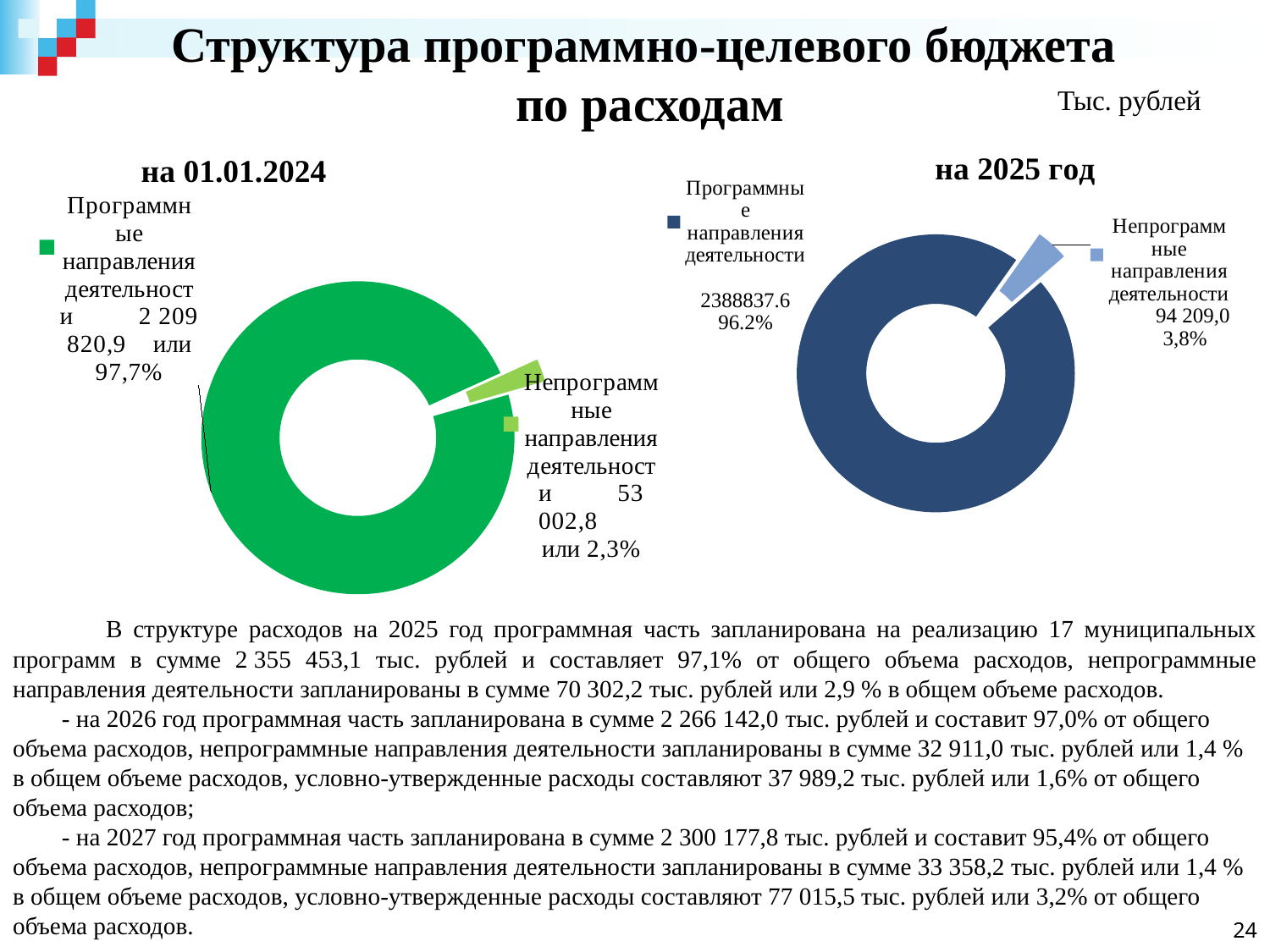
In the 'на 2025 год' chart, which category has the largest slice? Программные направления деятельности In the 'на 2025 год' chart, what value is shown for Непрограммные направления деятельности? 94 209,0 In the 'на 01.01.2024' chart, what value is shown for Программные направления деятельности? 2 209 820,9 In the 'на 01.01.2024' chart, what share is shown for Непрограммные направления деятельности? 2,3% In the 'на 2025 год' chart, what share is shown for Непрограммные направления деятельности? 3,8% In the 'на 2025 год' chart, what value is shown for Программные направления деятельности? 2388837.6 In the 'на 2025 год' chart, what share is shown for Программные направления деятельности? 96.2% In the 'на 01.01.2024' chart, which category has the smallest slice? Непрограммные направления деятельности Which is larger: the share of Непрограммные направления деятельности in the 'на 01.01.2024' chart or in the 'на 2025 год' chart? на 2025 год How many categories does the 'на 2025 год' chart show? 2 What type of chart is used for 'на 01.01.2024'? doughnut (pie) chart In the 'на 01.01.2024' chart, what value is shown for Непрограммные направления деятельности? 53 002,8